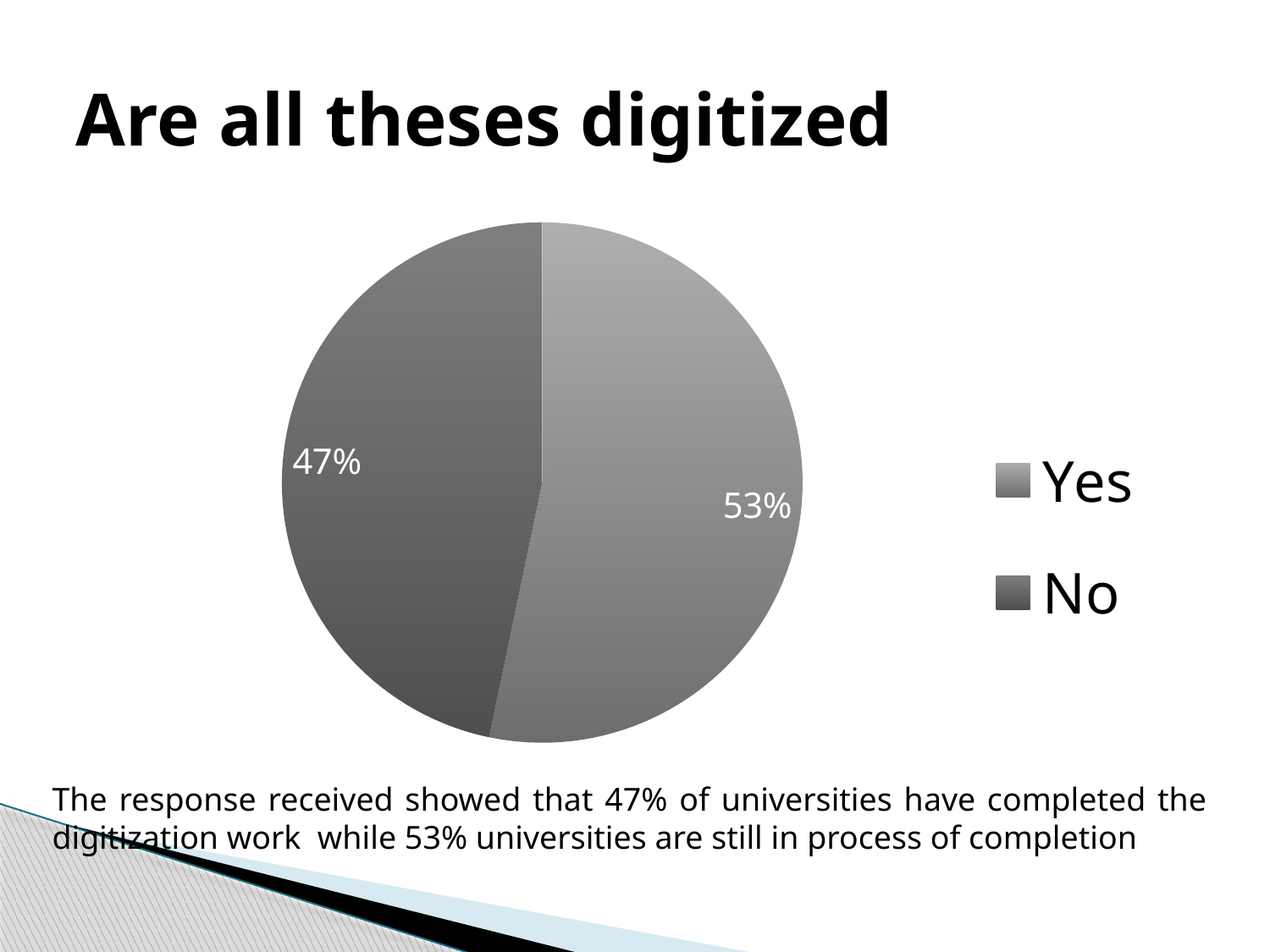
How many entries does the legend list? 2 Which slice is the smallest in the pie chart? No Which is larger, the Yes slice or the No slice? Yes What percentage is shown for the Yes slice? 53% What share of the pie does the No slice represent? 47% What kind of chart is shown on the slide? pie chart What is the difference in percentage points between the Yes and No slices? 6 Which legend entry is shown with the darker shade? No How many slices does the pie chart have? 2 Which slice is the largest in the pie chart? Yes What is the title of the chart on the slide? Are all theses digitized What percentage is shown for the No slice? 47%